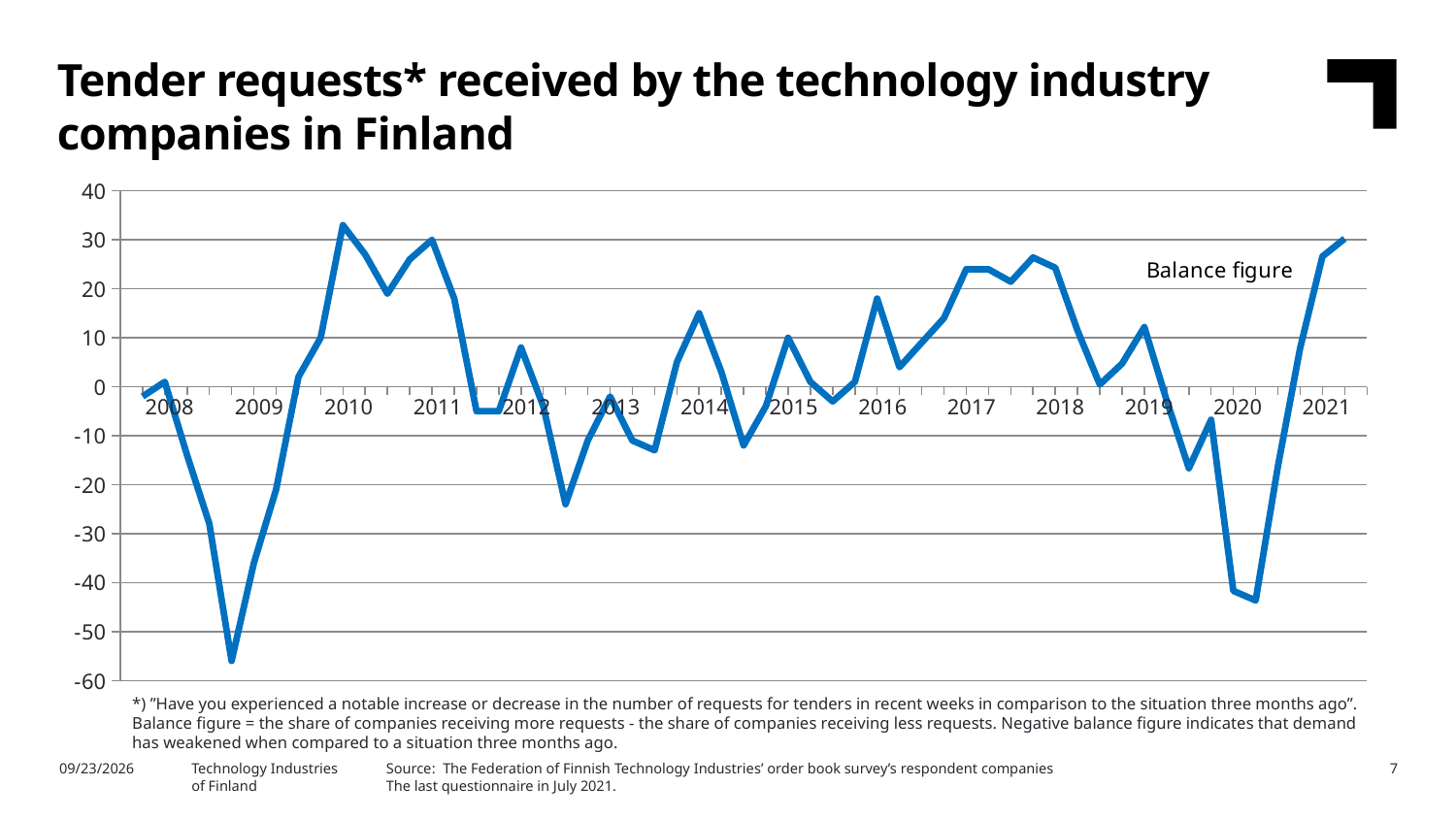
Is the last plotted value in 2021 greater or less than 20? greater What kind of chart is shown on the slide? line chart How many years are labelled on the x axis? 14 How many series does the chart show? 1 Which trough is lower, the one in 2009 or the one in 2020? 2009 Does the balance figure rise or fall from its 2020 low to the end of 2021? rise Is the lowest value of the balance figure in 2009 greater or less than -50? less What is the name of the series plotted on the chart? Balance figure Is the lowest value of the balance figure in 2020 greater or less than -40? less In which year does the balance figure reach its lowest point? 2009 What is the lowest value shown on the y axis? -60